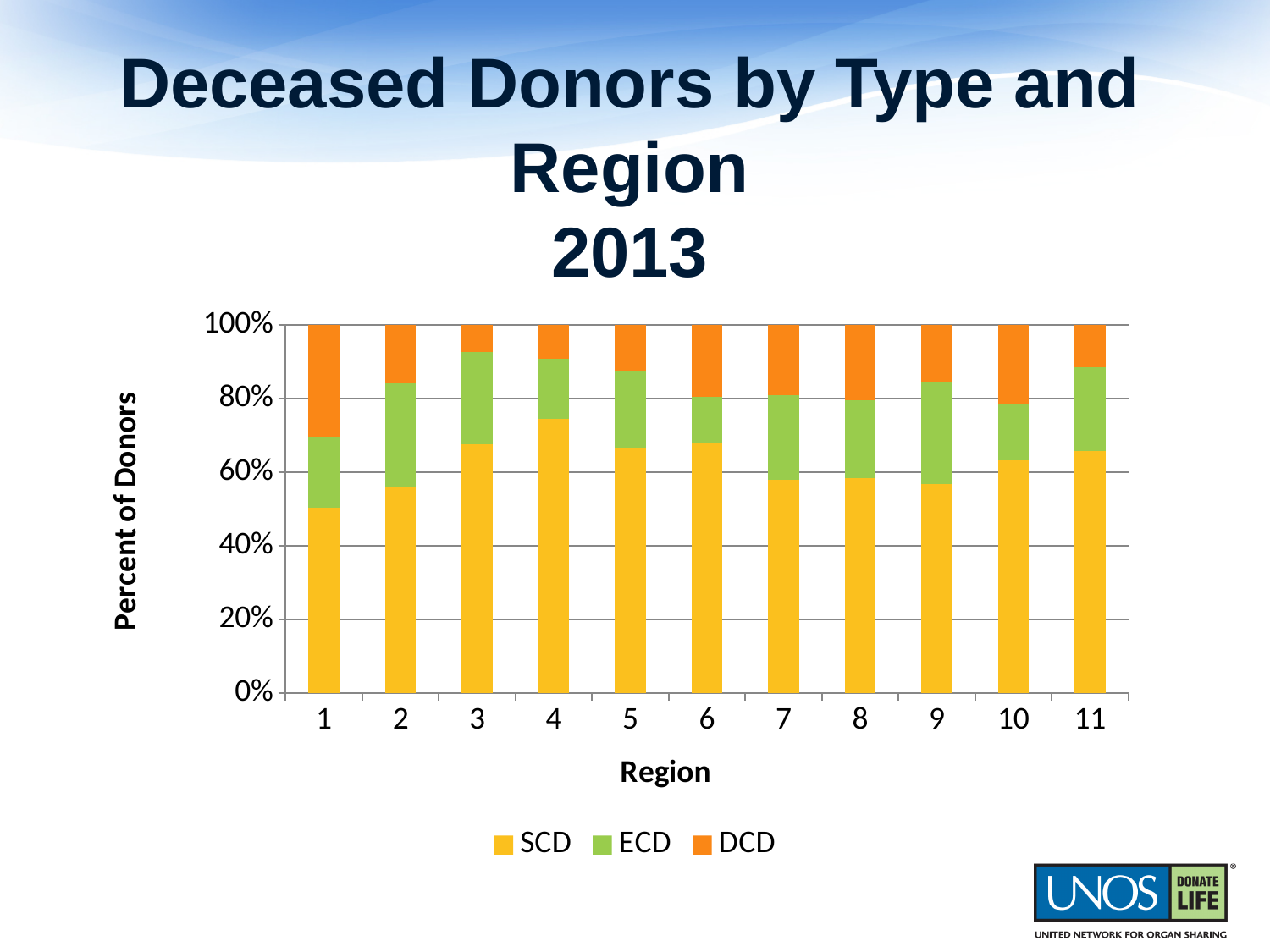
Which region has the largest DCD share of deceased donors? Region 1 What is the label on the chart's vertical axis? Percent of Donors Which region has a larger SCD share, Region 3 or Region 2? Region 3 What is the title of the chart on the slide? Deceased Donors by Type and Region 2013 Is the SCD share for Region 4 greater or less than 60%? greater Which region has the smallest SCD share of deceased donors? Region 1 How many regions are shown along the x axis of the chart? 11 Which region has the largest SCD share of deceased donors? Region 4 How many series does the chart's legend list? 3 Is the SCD share for Region 1 greater or less than 60%? less Is the SCD share for Region 2 greater or less than 60%? less What kind of chart is shown on the slide? Stacked bar chart